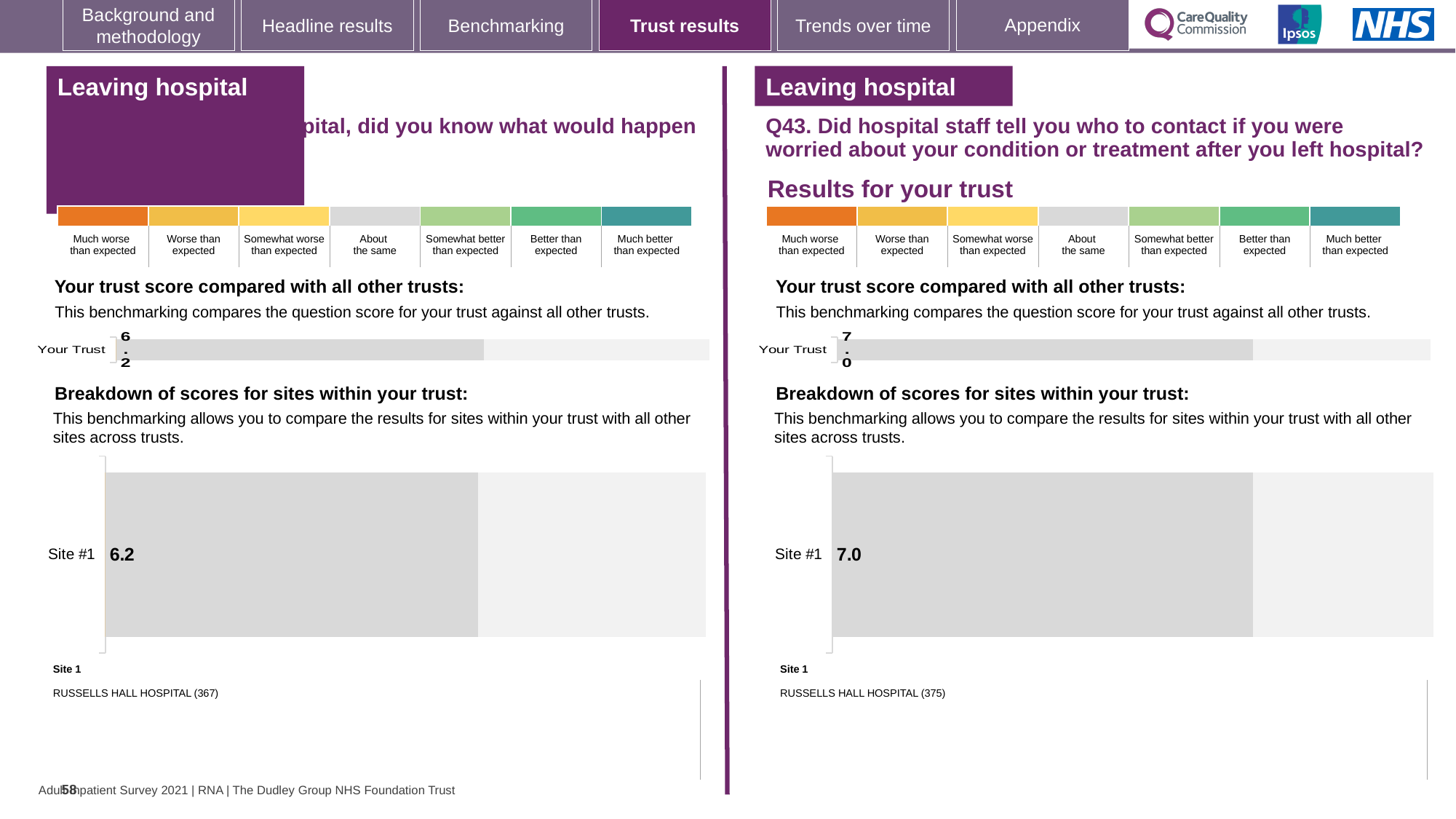
What kind of chart is used to show the breakdown of scores for sites within your trust on the right-hand side (Q43)? Bar chart How many sites are shown in the breakdown of scores for sites within your trust on the right-hand side (Q43)? 1 On the left-hand side of the slide, which hospital is listed as Site 1? RUSSELLS HALL HOSPITAL (367) On the left-hand side of the slide, what is the score shown for Site #1? 6.2 Which is larger: the Site #1 score on the left-hand side of the slide or the Site #1 score on the right-hand side (Q43)? Right-hand side (Q43) What is the difference between the Site #1 score on the right-hand side (Q43) and the Site #1 score on the left-hand side of the slide? 0.8 On the right-hand side of the slide (Q43), what is the score shown for Your Trust? 7.0 On the left-hand side of the slide, what is the score shown for Your Trust? 6.2 On the right-hand side of the slide (Q43), which hospital is listed as Site 1? RUSSELLS HALL HOSPITAL (375) How many sites are shown in the breakdown of scores for sites within your trust on the left-hand side of the slide? 1 On the right-hand side of the slide (Q43), is the Your Trust score the same as the Site #1 score? Yes On the right-hand side of the slide (Q43), what is the score shown for Site #1? 7.0